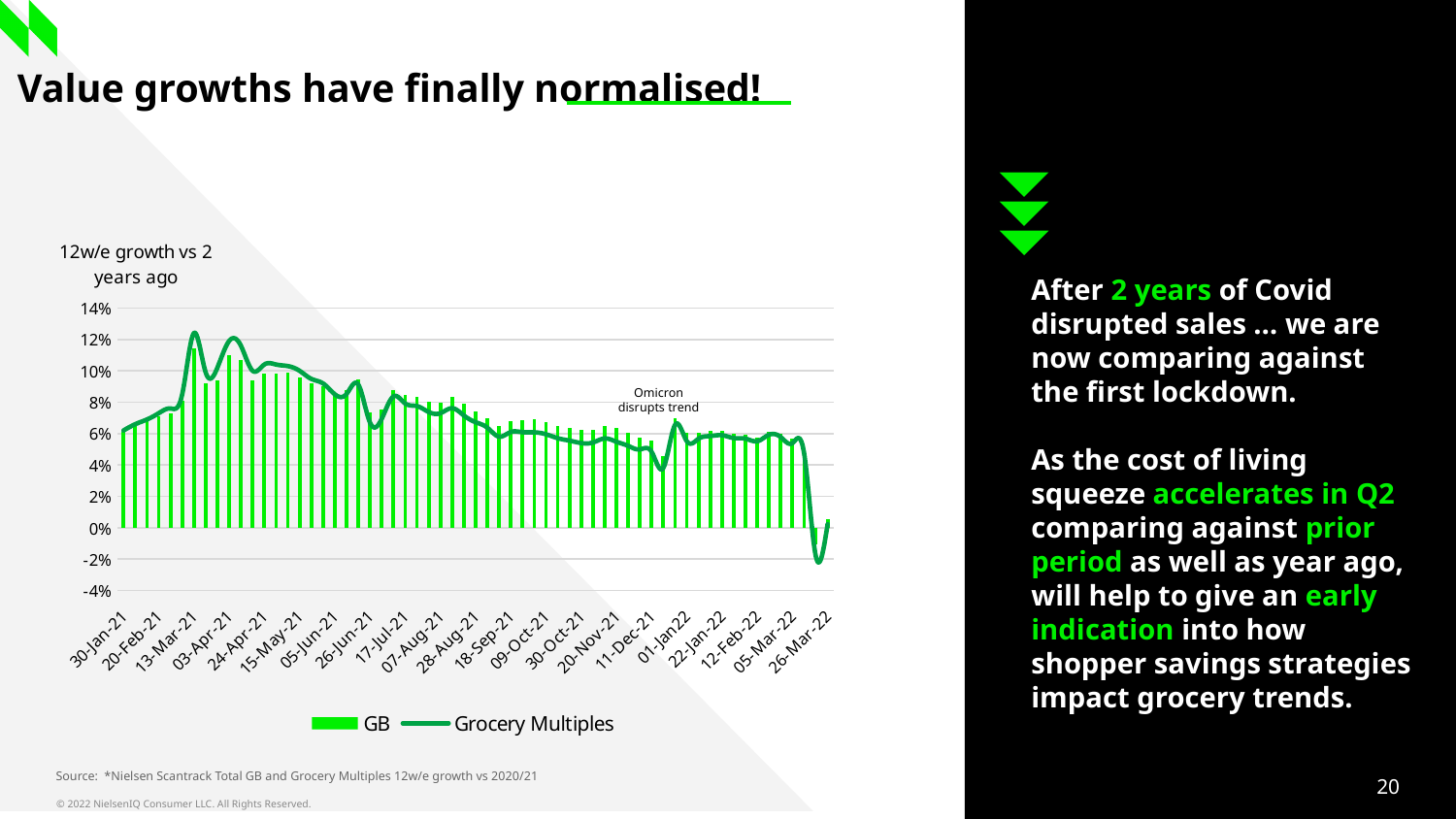
In which month does the Grocery Multiples line reach its lowest value? March 2022 What event does the annotation on the chart say disrupts the trend? Omicron Is the GB value at 09-Oct-21 greater or less than 10%? less Overall, do the growth values rise or fall from 30-Jan-21 to 26-Mar-22? fall What is the title of the chart's vertical axis / chart heading? 12w/e growth vs 2 years ago Is the Grocery Multiples value at 13-Mar-21 greater or less than 10%? greater What kind of chart is shown on the slide? A combined bar and line chart Is the GB value at 30-Jan-21 greater or less than 4%? greater How many series does the chart legend list? 2 Which is larger: the Grocery Multiples value at 13-Mar-21 or at 26-Mar-22? 13-Mar-21 Which series is drawn as bars and which as a line? GB is bars; Grocery Multiples is the line